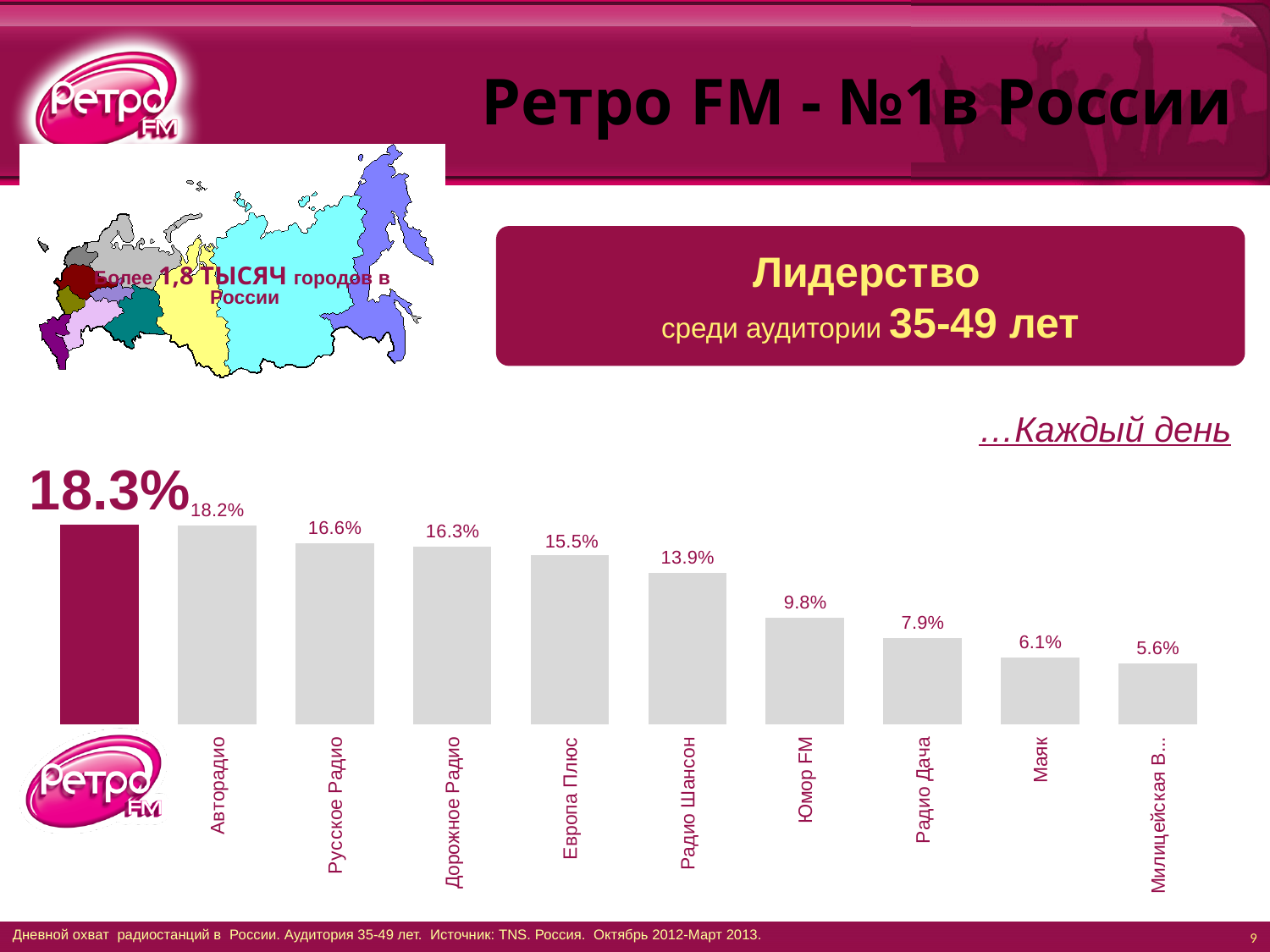
What is the value shown for Европа Плюс? 15.5% What is the value shown for Авторадио? 18.2% Do the values rise or fall from left to right across the bars? fall What is the value shown for Русское Радио? 16.6% What is the value shown for Юмор FM? 9.8% What is the difference between the values for Дорожное Радио and Радио Дача? 8.4% What kind of chart is shown on the slide? bar chart Which has a larger value, Европа Плюс or Радио Дача? Европа Плюс What is the difference between the values for Радио Шансон and Юмор FM? 4.1% What is the value shown for the Ретро FM bar (the highlighted first bar)? 18.3% What is the value shown for Маяк? 6.1% How many bars are shown in the chart? 10